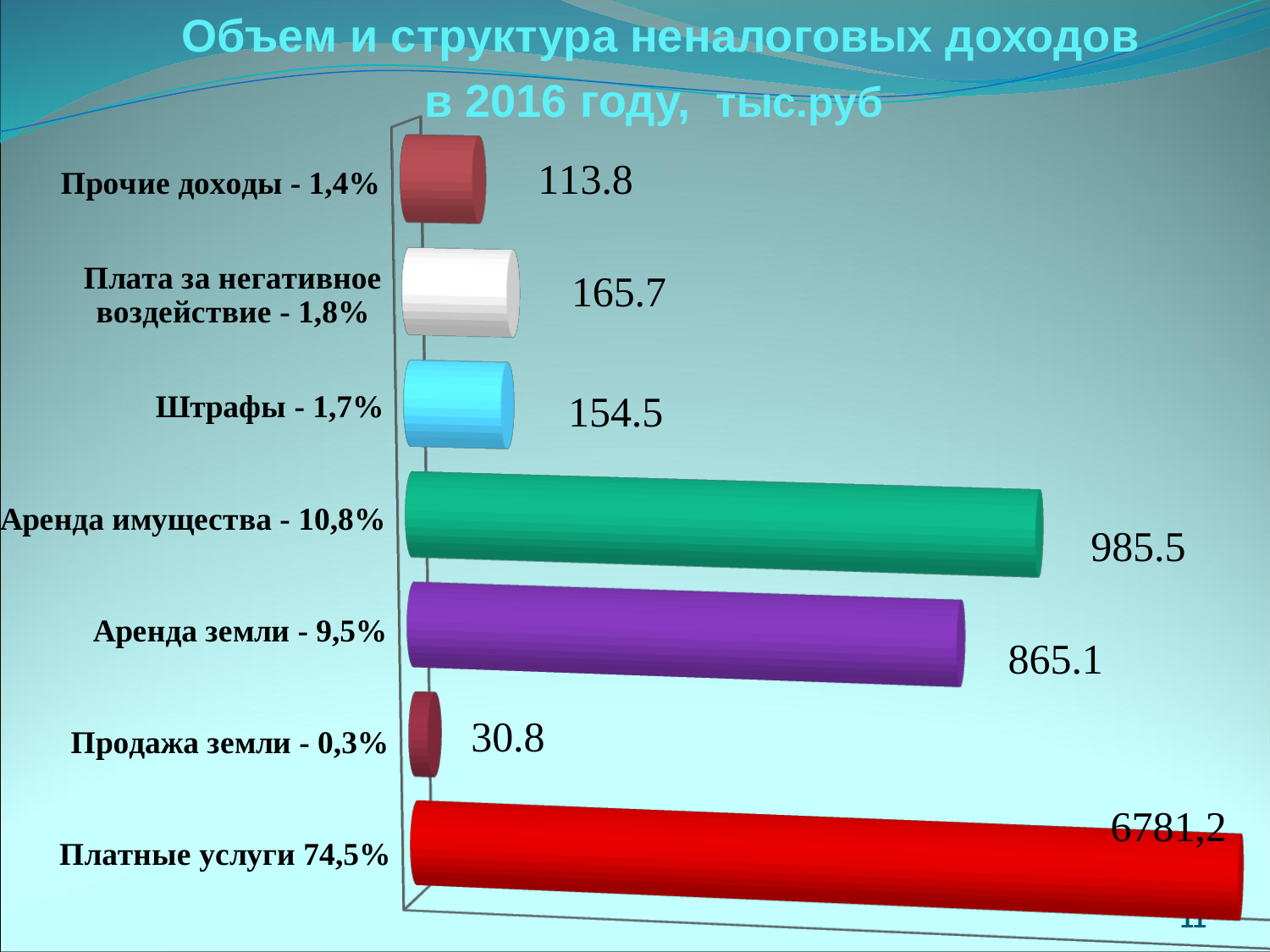
What share of non-tax revenue does Платные услуги account for, according to its label? 74,5% Which is larger, the value for Аренда земли or the value for Аренда имущества? Аренда имущества What is the difference between the values for Аренда имущества and Аренда земли? 120.4 What is the value for Штрафы? 154.5 What kind of chart is shown on the slide? Bar chart Which category has the highest value? Платные услуги What is the value for Платные услуги? 6781,2 What is the value for Аренда имущества? 985.5 How many categories are shown in the chart? 7 What is the difference between the values for Плата за негативное воздействие and Прочие доходы? 51.9 What is the value for Продажа земли? 30.8 Which category has the lowest value? Продажа земли